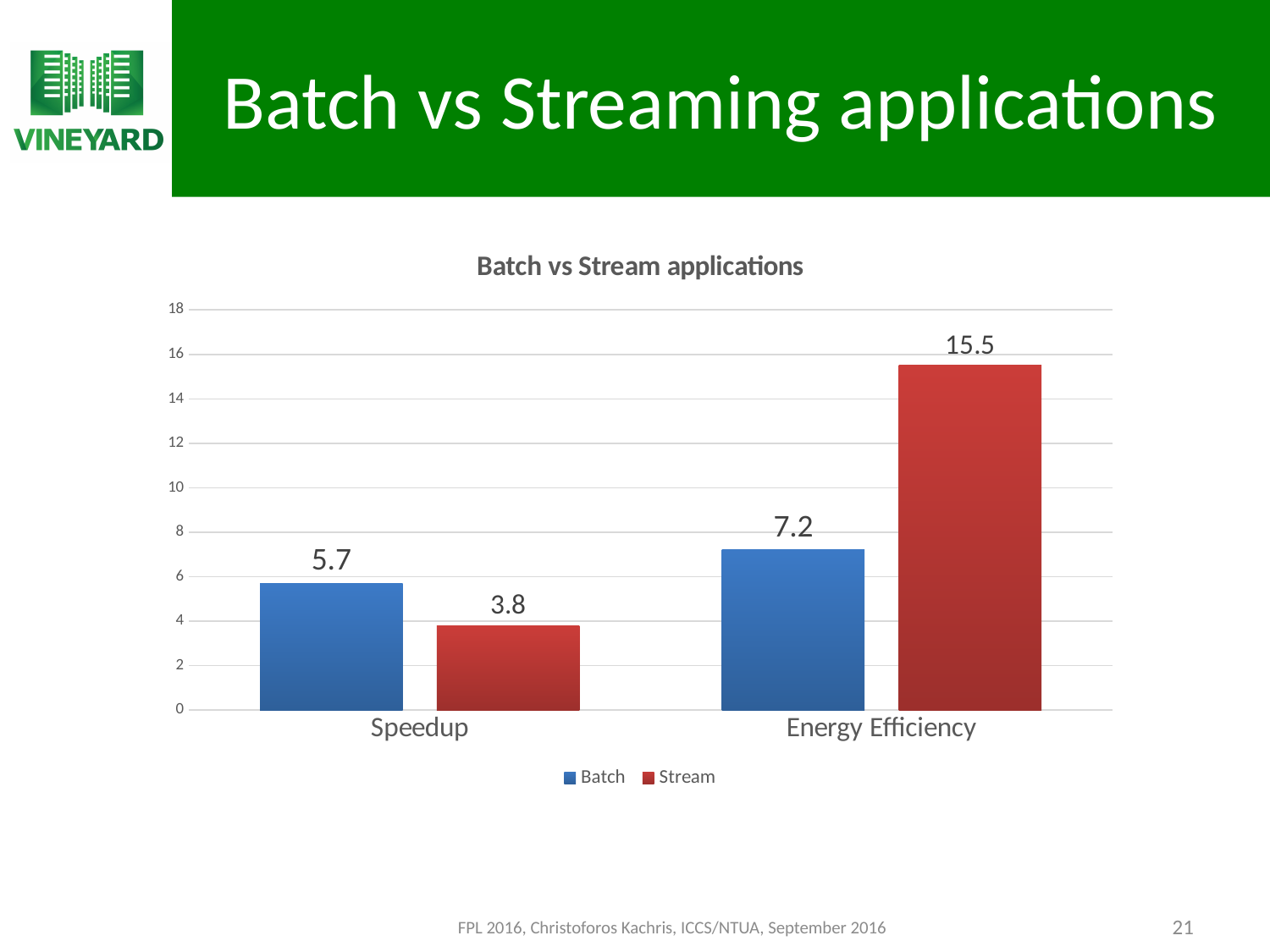
For Speedup, which series has the larger value, Batch or Stream? Batch Which bar has the highest value in the chart? Stream, Energy Efficiency How many categories are shown on the x axis? 2 What is the Batch value for Energy Efficiency? 7.2 What is the Batch value for Speedup? 5.7 What is the Stream value for Speedup? 3.8 How many series does the legend list? 2 What is the Stream value for Energy Efficiency? 15.5 What type of chart is shown on the slide? Bar chart What is the difference between the Batch and Stream values for Speedup? 1.9 Which bar has the lowest value in the chart? Stream, Speedup What is the difference between the Stream and Batch values for Energy Efficiency? 8.3